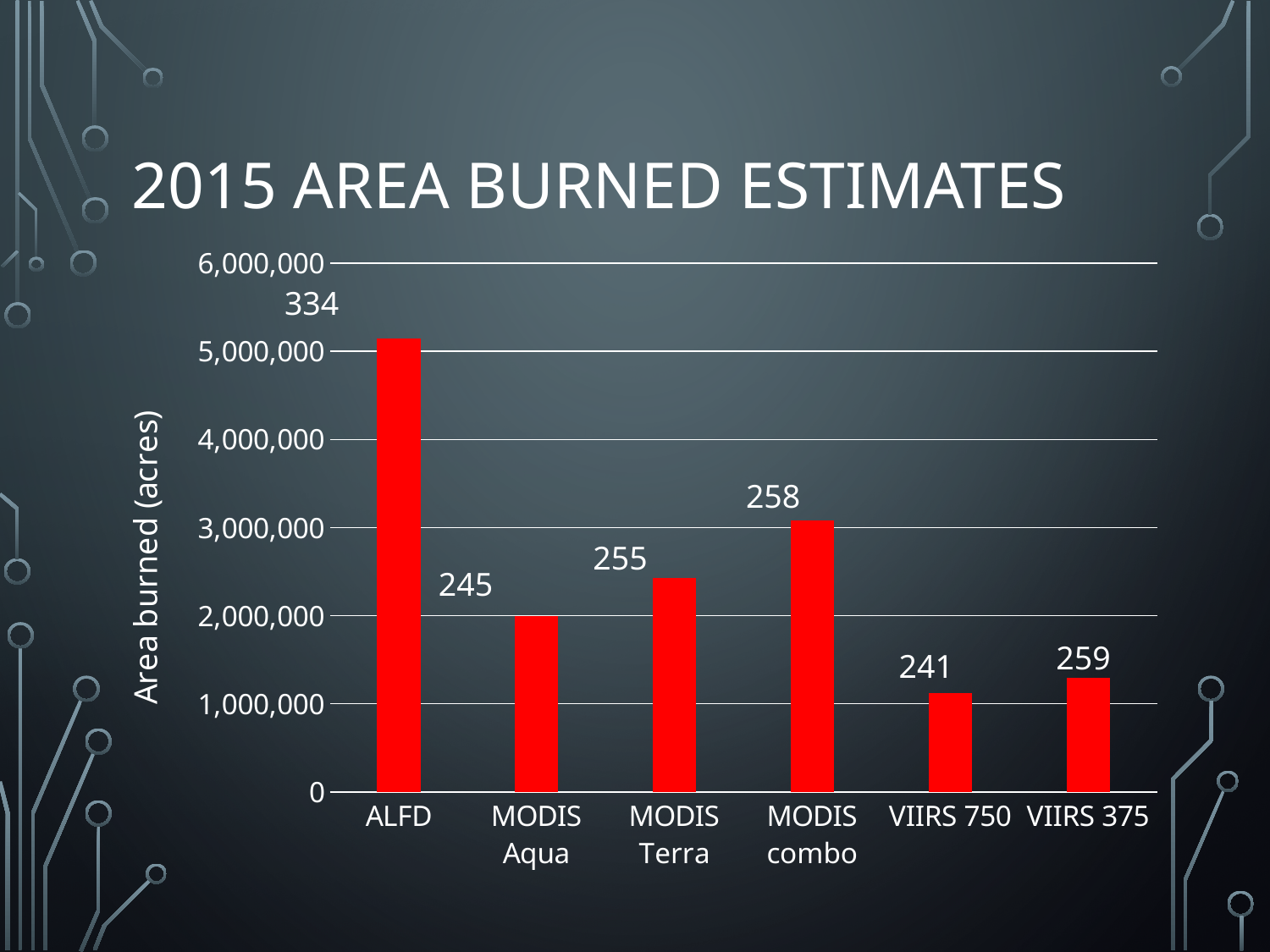
What kind of chart is shown on the slide? bar chart Is the area burned for MODIS Aqua greater or less than 3,000,000 acres? less What number is printed above the bar for ALFD? 334 Which has a larger area burned, MODIS Terra or MODIS Aqua? MODIS Terra How many categories are shown on the x axis of the chart? 6 What is the label on the y axis of the chart? Area burned (acres) Is the area burned for MODIS Terra greater or less than 2,000,000 acres? greater Which category has the highest area burned? ALFD What is the title of the chart? 2015 AREA BURNED ESTIMATES Is the area burned for ALFD greater or less than 5,000,000 acres? greater